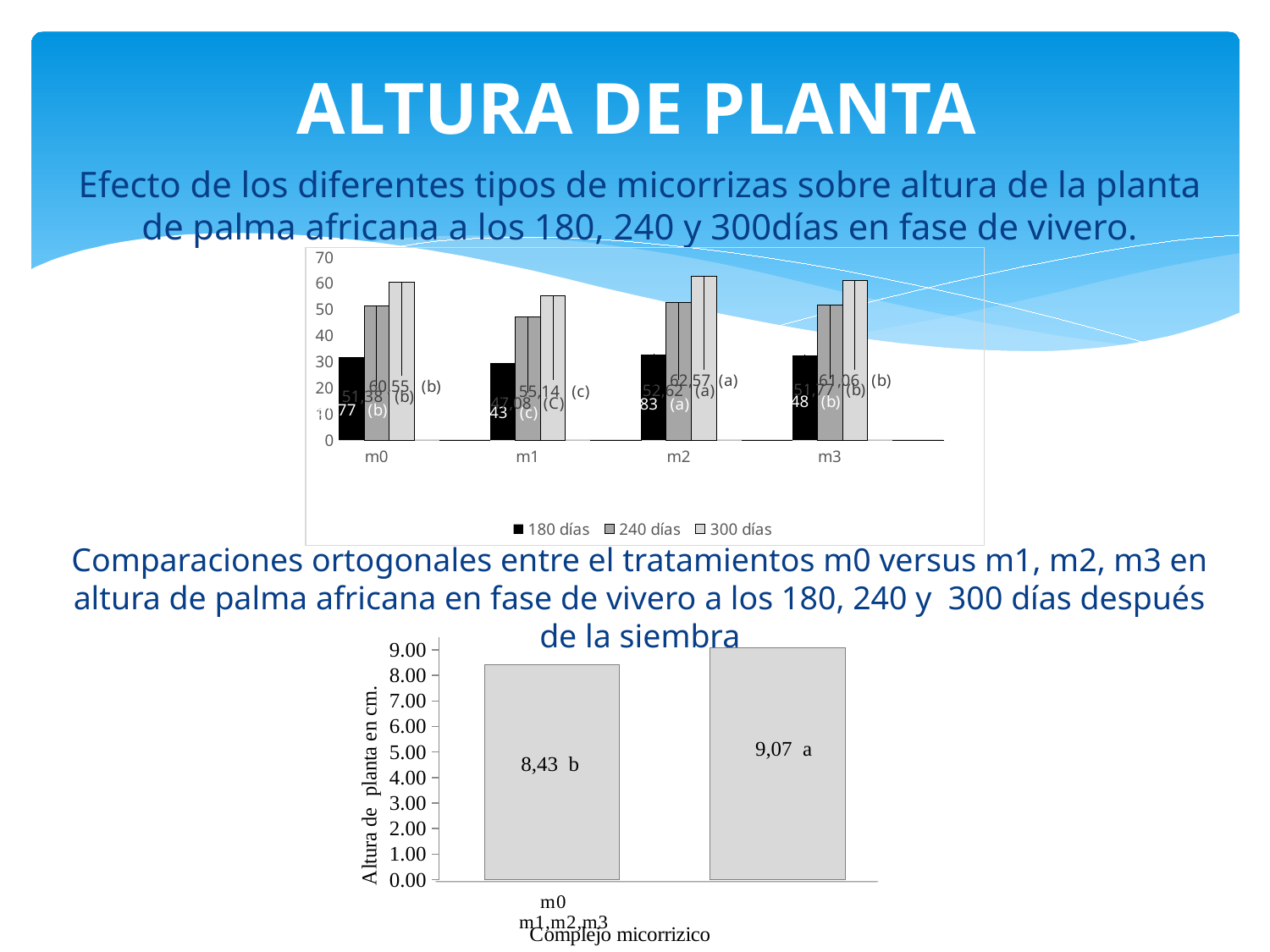
In the top chart, is the 180 días value for m0 greater or less than 40? less In the top chart, what is the 300 días value for m2? 62,57 In the bottom chart, what is the value for m0? 8,43 What is the y-axis title of the bottom chart? Altura de planta en cm. How many series does the legend of the top chart list? 3 How many bars are plotted in the bottom chart? 2 In the bottom chart, what is the value for m1,m2,m3? 9,07 In the top chart, which category has the lowest 300 días value? m1 In the bottom chart, what is the difference between the m1,m2,m3 value and the m0 value? 0,64 How many categories are shown on the x axis of the top chart? 4 What kind of chart is the bottom chart (Comparaciones ortogonales)? bar chart In the bottom chart, which bar is taller, m0 or m1,m2,m3? m1,m2,m3